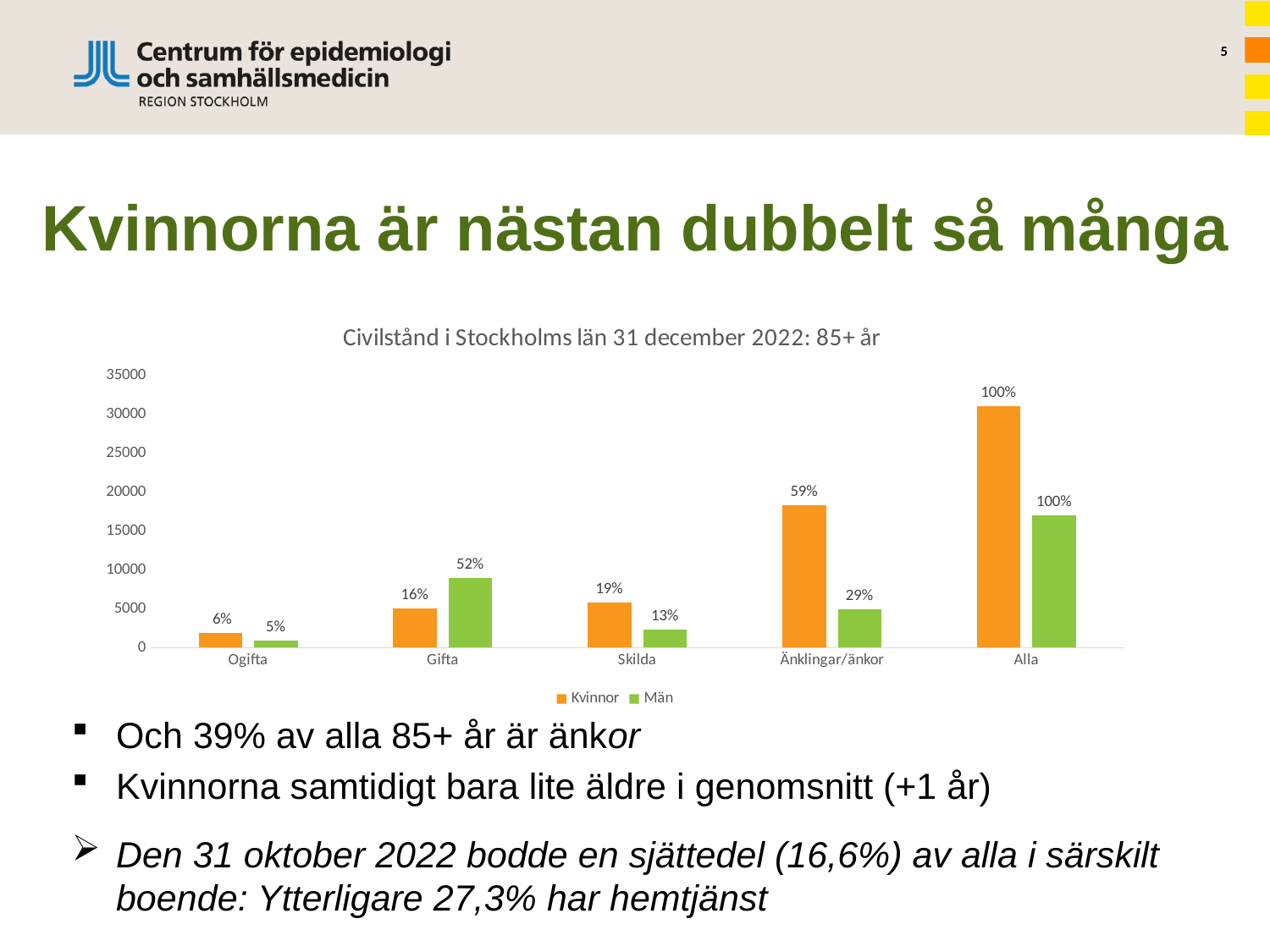
For Gifta, what is the difference in percentage points between the Män label and the Kvinnor label? 36 percentage points What is the data label on the Kvinnor bar for Änklingar/änkor? 59% What is the data label on the Män bar for Änklingar/änkor? 29% Which category has the lowest Män data label? Ogifta Is the Män bar for Gifta greater or less than 10000 on the y axis? less Excluding the Alla category, which category has the highest Män data label? Gifta For Skilda, which bar is taller, Kvinnor or Män? Kvinnor What is the data label on the Kvinnor bar for Gifta? 16% What is the data label on the Män bar for Skilda? 13% How many categories are shown on the x axis? 5 What is the title of the chart? Civilstånd i Stockholms län 31 december 2022: 85+ år Is the Kvinnor bar for Alla greater or less than 30000 on the y axis? greater